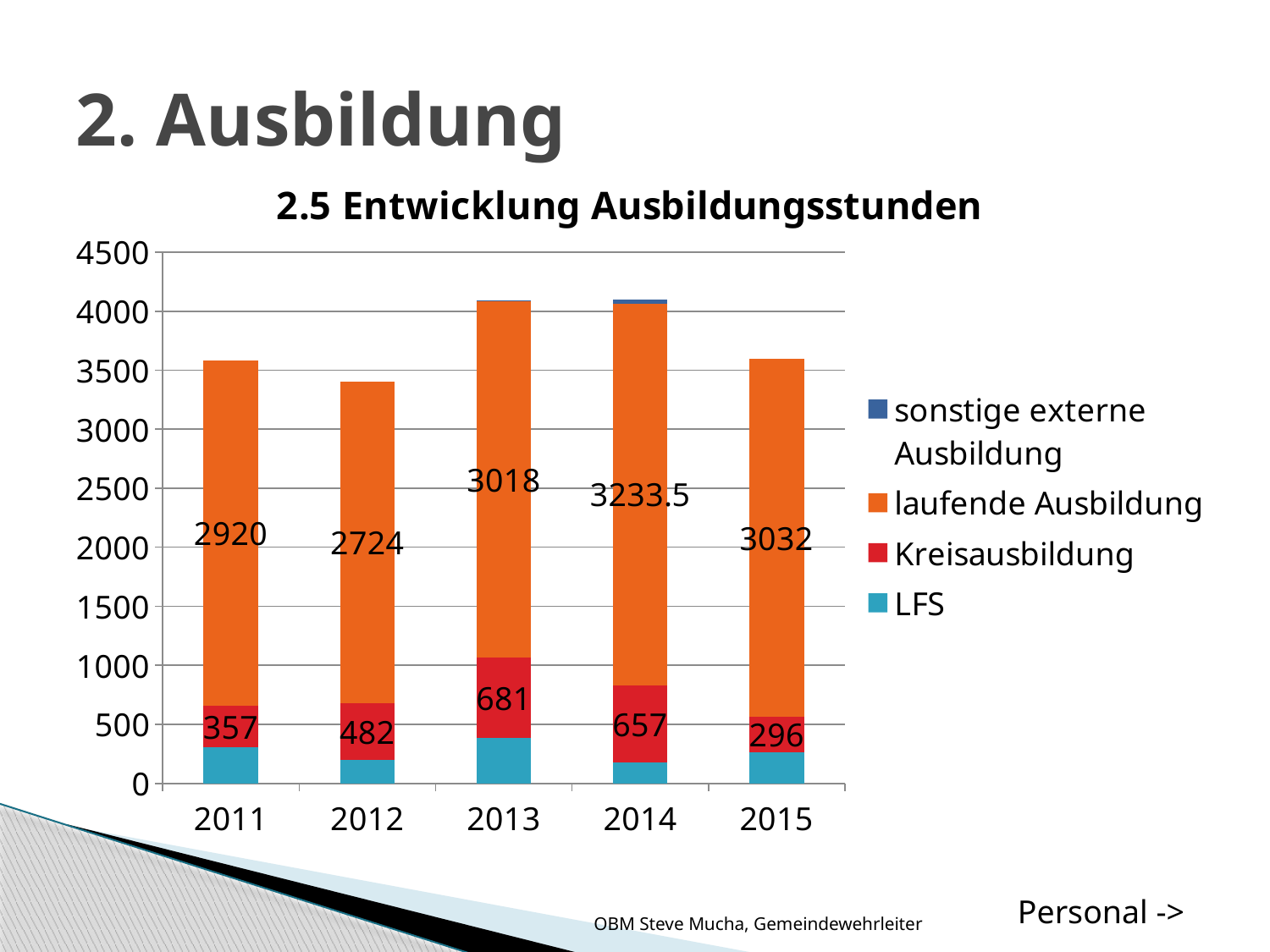
What is the value for laufende Ausbildung in 2014? 3233.5 Is the total height of the 2012 bar greater or less than 3500? less Is the total height of the 2013 bar greater or less than 4000? greater How many years are shown on the x axis? 5 How many series does the legend list? 4 What is the value for Kreisausbildung in 2013? 681 In which year is the value for laufende Ausbildung highest? 2014 What is the difference between the laufende Ausbildung values for 2013 and 2011? 98 What is the value for laufende Ausbildung in 2012? 2724 What kind of chart is shown on the slide? Stacked bar chart In which year is the value for Kreisausbildung lowest? 2015 Which is larger, the Kreisausbildung value for 2012 or for 2014? 2014